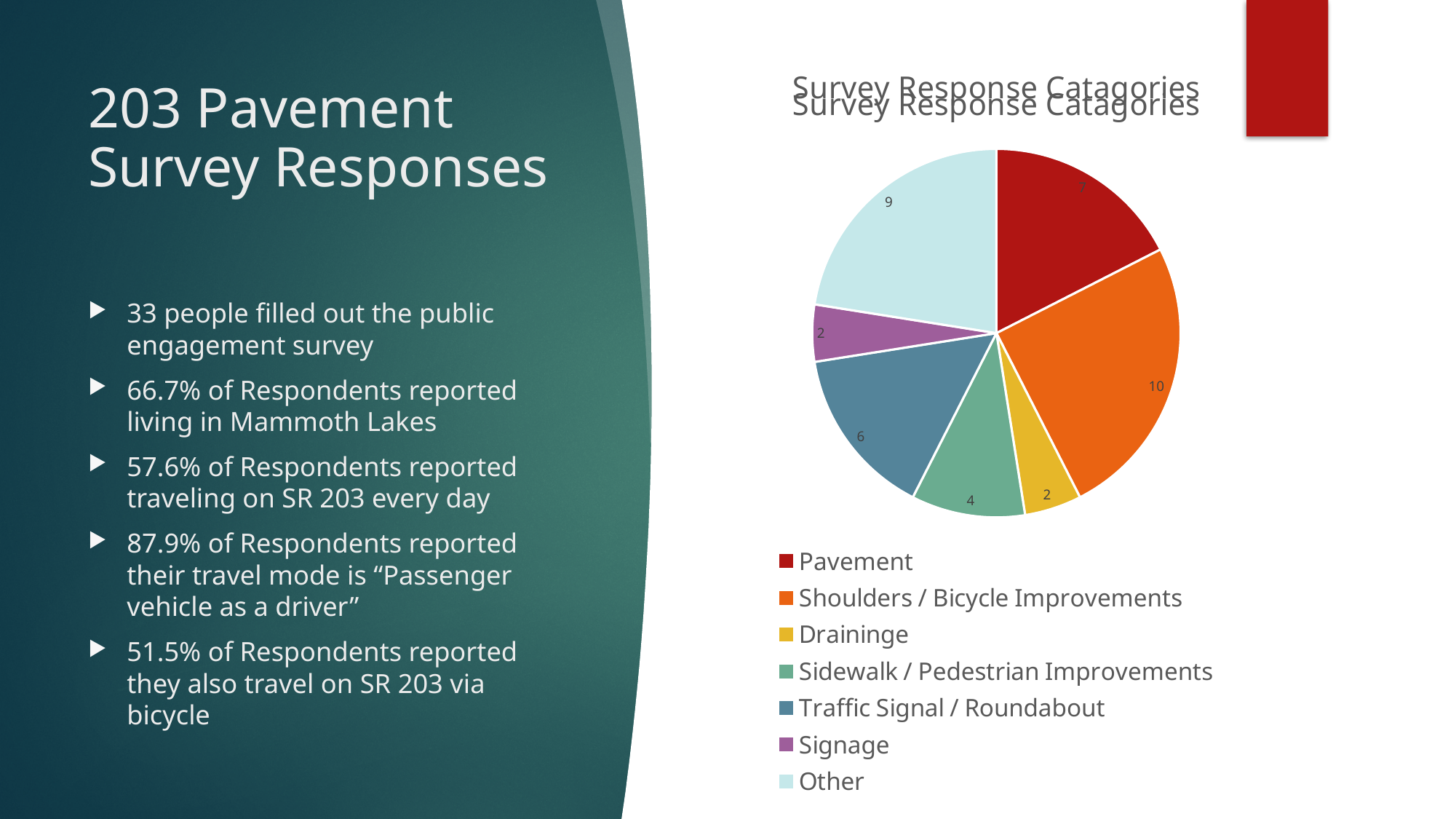
Which is larger, Traffic Signal / Roundabout or Draininge? Traffic Signal / Roundabout What is the difference between the values for Other and Sidewalk / Pedestrian Improvements? 5 How many categories does the pie chart have? 7 What is the title of the chart? Survey Response Catagories Which category has the highest value? Shoulders / Bicycle Improvements What is the value for Sidewalk / Pedestrian Improvements? 4 Which legend entry is shown in orange? Shoulders / Bicycle Improvements What kind of chart is shown on the slide? pie chart What is the value for Signage? 2 What is the value for Traffic Signal / Roundabout? 6 What is the value for Other? 9 What is the value for Shoulders / Bicycle Improvements? 10